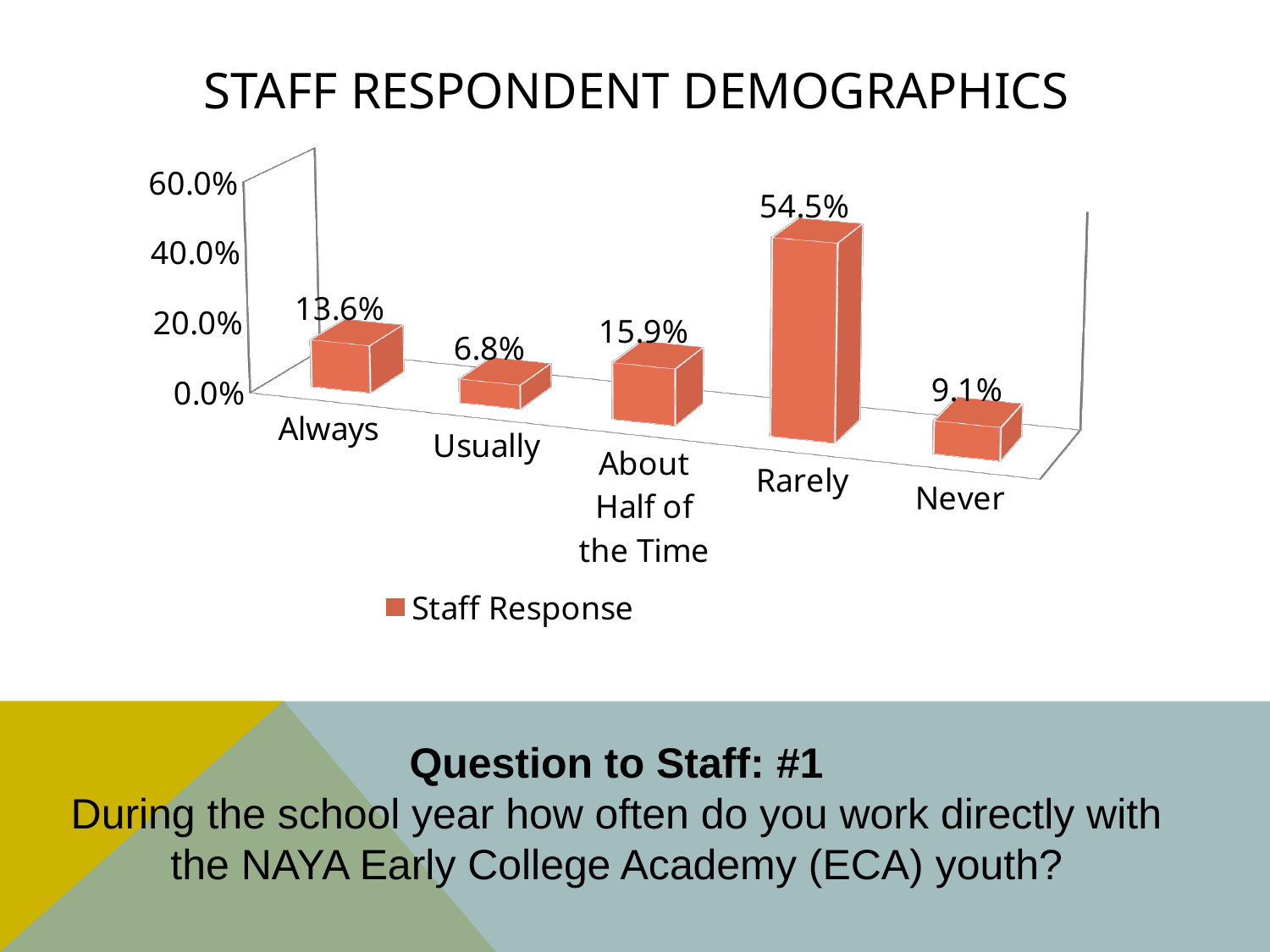
What kind of chart is shown on the slide? Bar chart What is the value for Always? 13.6% Which is larger, the value for Always or the value for Never? Always What is the value for Usually? 6.8% What is the value for Rarely? 54.5% Which category has the lowest value? Usually What is the difference between the values for Rarely and About Half of the Time? 38.6% What series name does the legend show? Staff Response How many categories are shown on the x axis? 5 Which category has the highest value? Rarely What is the value for About Half of the Time? 15.9% What is the value for Never? 9.1%